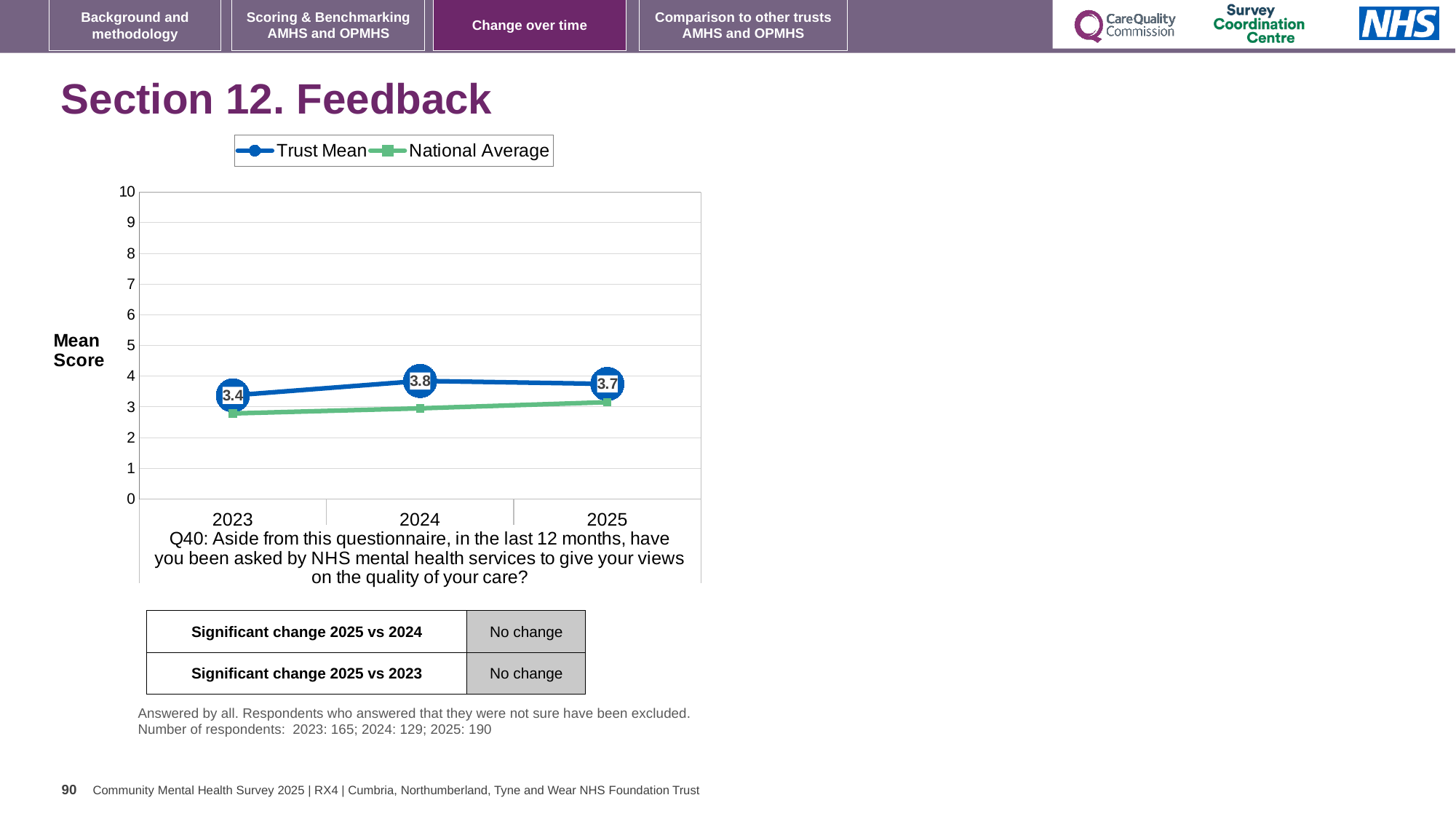
How many years are plotted on the x axis? 3 Is the National Average value for 2023 greater or less than 4? less How many series does the legend list? 2 What is the difference between the Trust Mean in 2024 and in 2023? 0.4 What is the Trust Mean value for 2024? 3.8 What is the Trust Mean value for 2025? 3.7 What kind of chart is shown on the slide? line chart In which year is the Trust Mean highest? 2024 In which year is the Trust Mean lowest? 2023 In 2024, which is larger, the Trust Mean or the National Average? Trust Mean Does the National Average rise or fall from 2023 to 2025? rise What is the Trust Mean value for 2023? 3.4